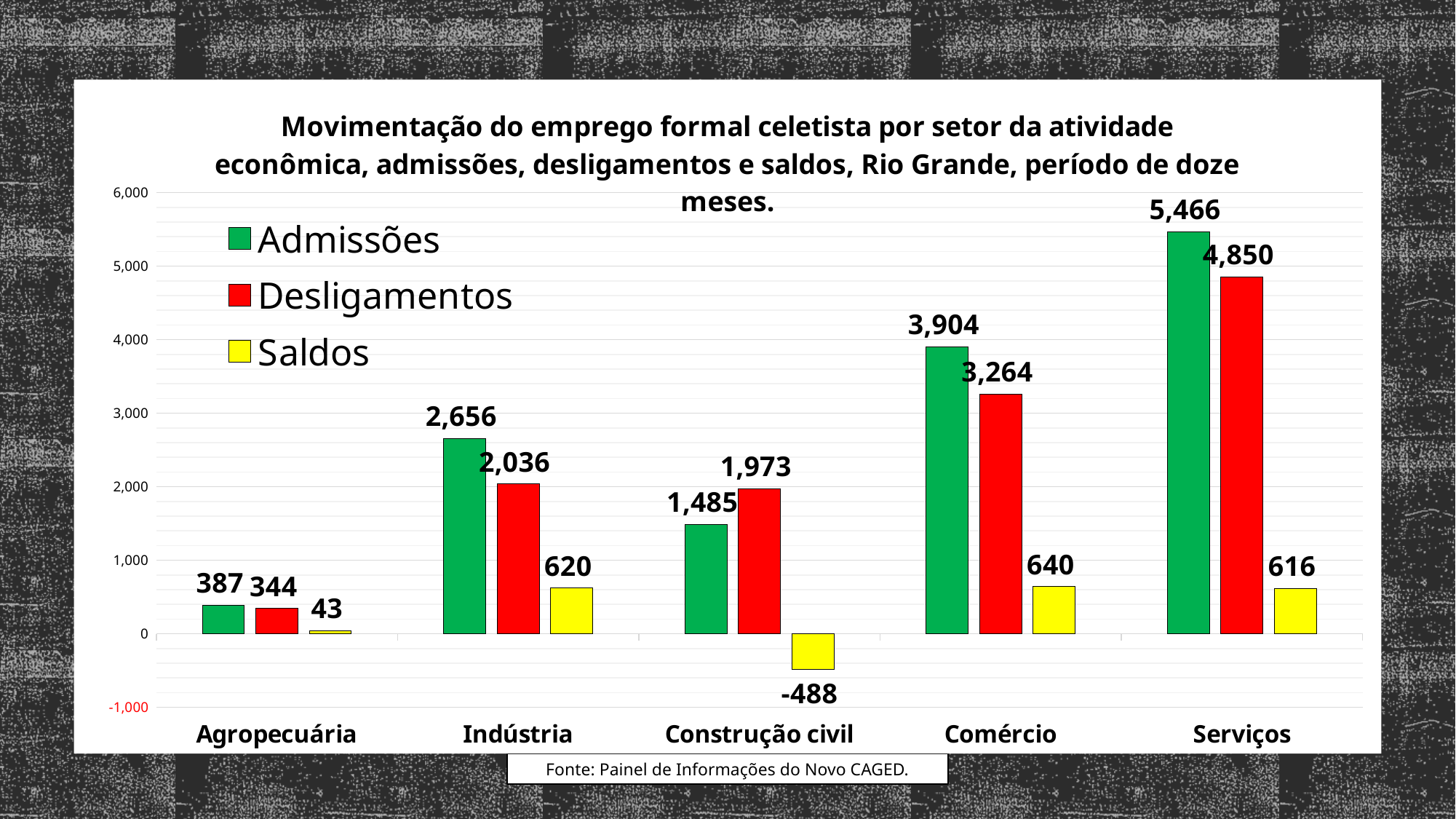
Which is larger for Construção civil, Admissões or Desligamentos? Desligamentos How many series does the legend list? 3 What is the Admissões value for Serviços? 5,466 What is the Desligamentos value for Indústria? 2,036 What kind of chart is shown on the slide? Bar chart What is the difference between Admissões and Desligamentos for Comércio? 640 How many sectors are shown on the x axis? 5 Which sector has the highest Admissões value? Serviços What is the Saldos value for Construção civil? -488 Which sector has the lowest Saldos value? Construção civil Which colour represents the Saldos series? Yellow Is the Desligamentos value for Serviços greater or less than 4,000? greater